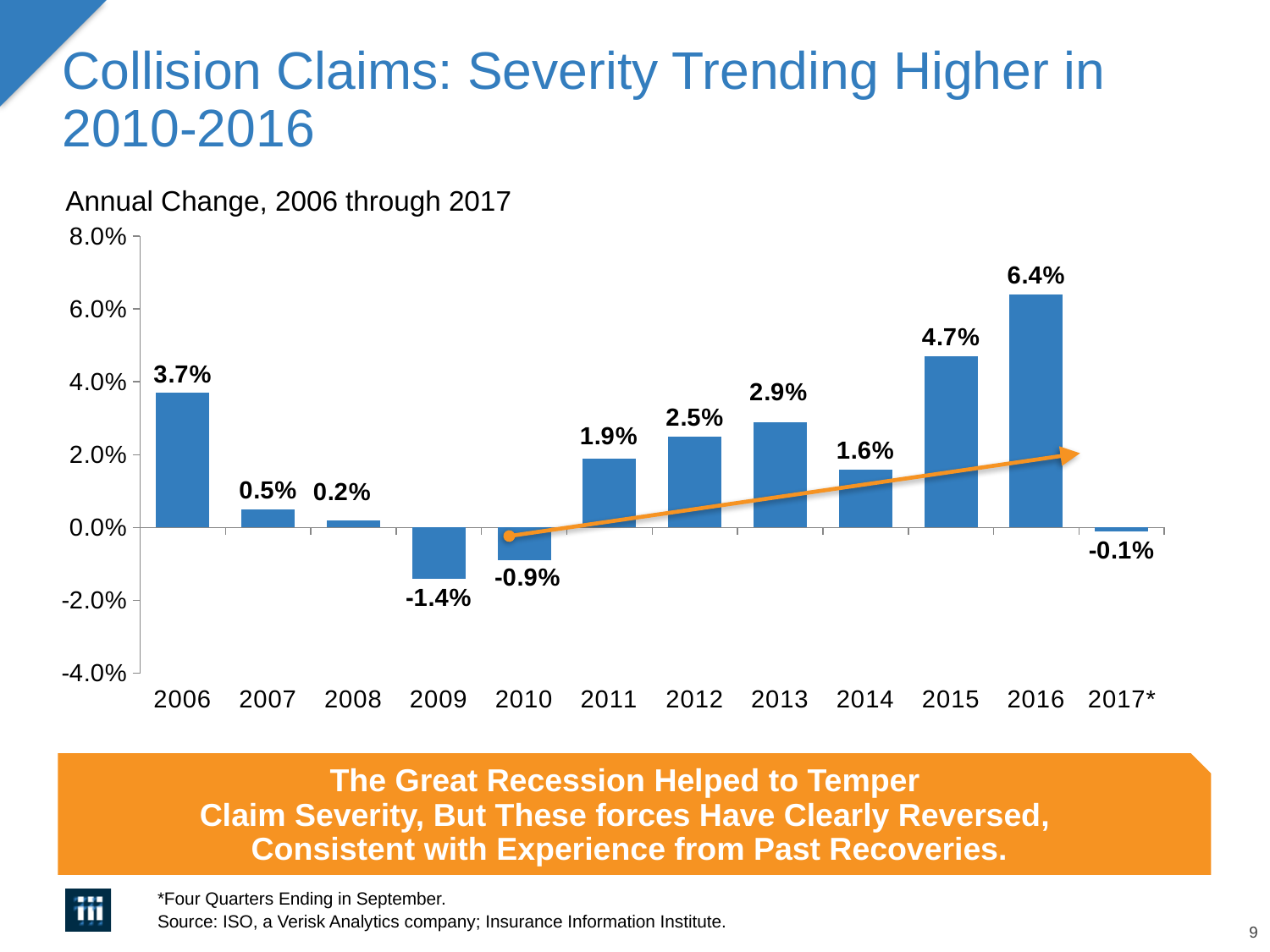
Is the value for 2015 greater or less than 4.0%? greater Which year has the highest annual change in the chart? 2016 How many years are shown on the x axis of the chart? 12 What is the value shown for 2017*? -0.1% Do the values generally rise or fall from 2010 to 2016? Rise What is the difference between the 2016 value and the 2015 value? 1.7% What is the annual change shown for 2009? -1.4% What is the annual change in collision claim severity for 2016? 6.4% Which year has the larger annual change, 2006 or 2013? 2006 What kind of chart is shown on the slide? Bar chart What is the subtitle printed above the chart? Annual Change, 2006 through 2017 Which year has the lowest annual change in the chart? 2009